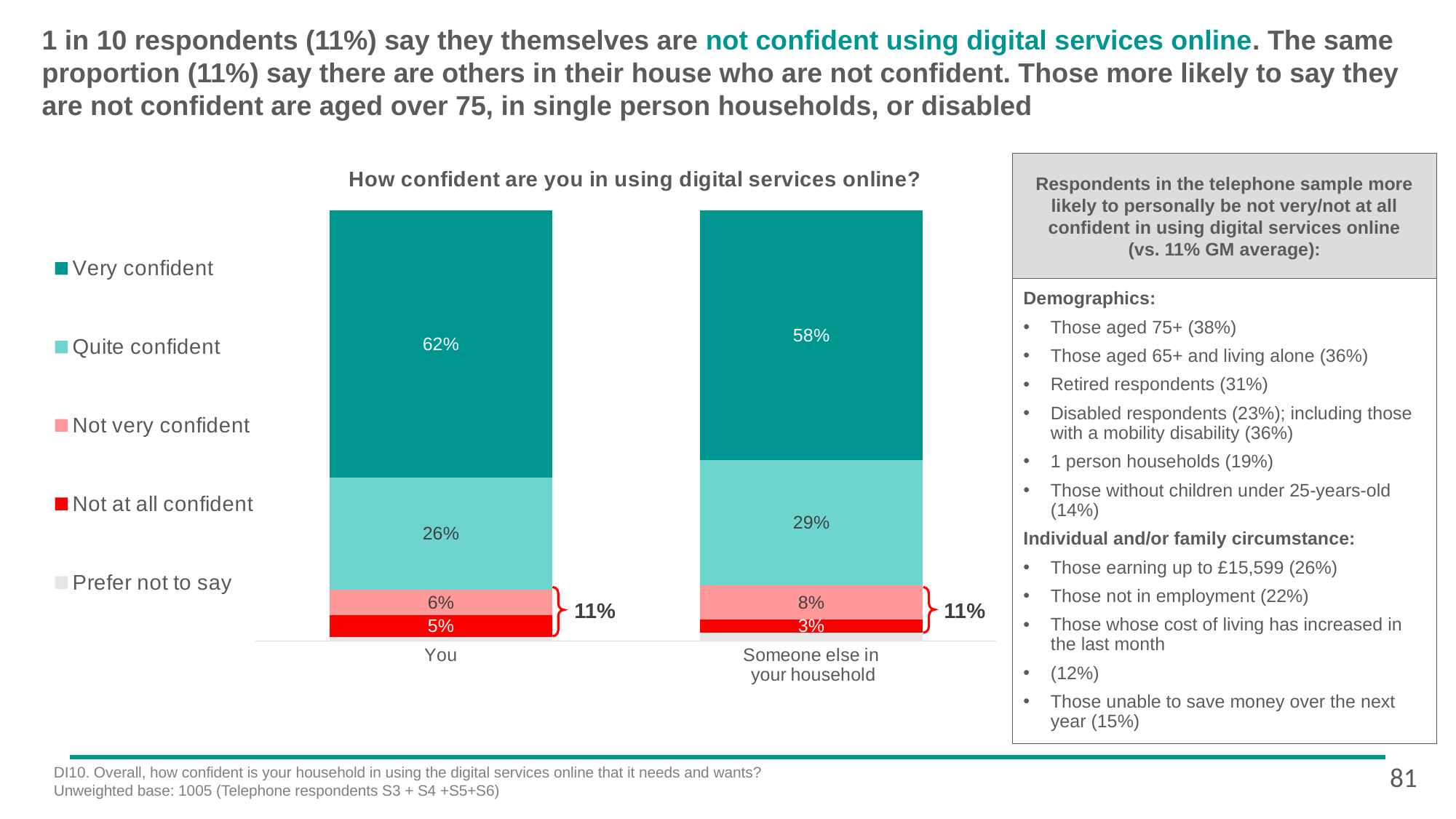
How many categories are shown on the x axis? 2 What is the 'Quite confident' value for 'Someone else in your household'? 29% Which legend entry is shown in bright red? Not at all confident What percentage of respondents say they themselves are 'Very confident'? 62% What is the 'Not at all confident' value for 'You'? 5% What is the combined 'Not very confident' and 'Not at all confident' share for 'You', as shown by the bracket label? 11% How many series does the legend list? 5 What is the difference between the 'Very confident' values for 'You' and 'Someone else in your household'? 4 percentage points What is the chart's title? How confident are you in using digital services online? What is the 'Not very confident' value for 'Someone else in your household'? 8% Which category has the higher 'Very confident' value, 'You' or 'Someone else in your household'? You What kind of chart is shown on the slide? Stacked bar chart